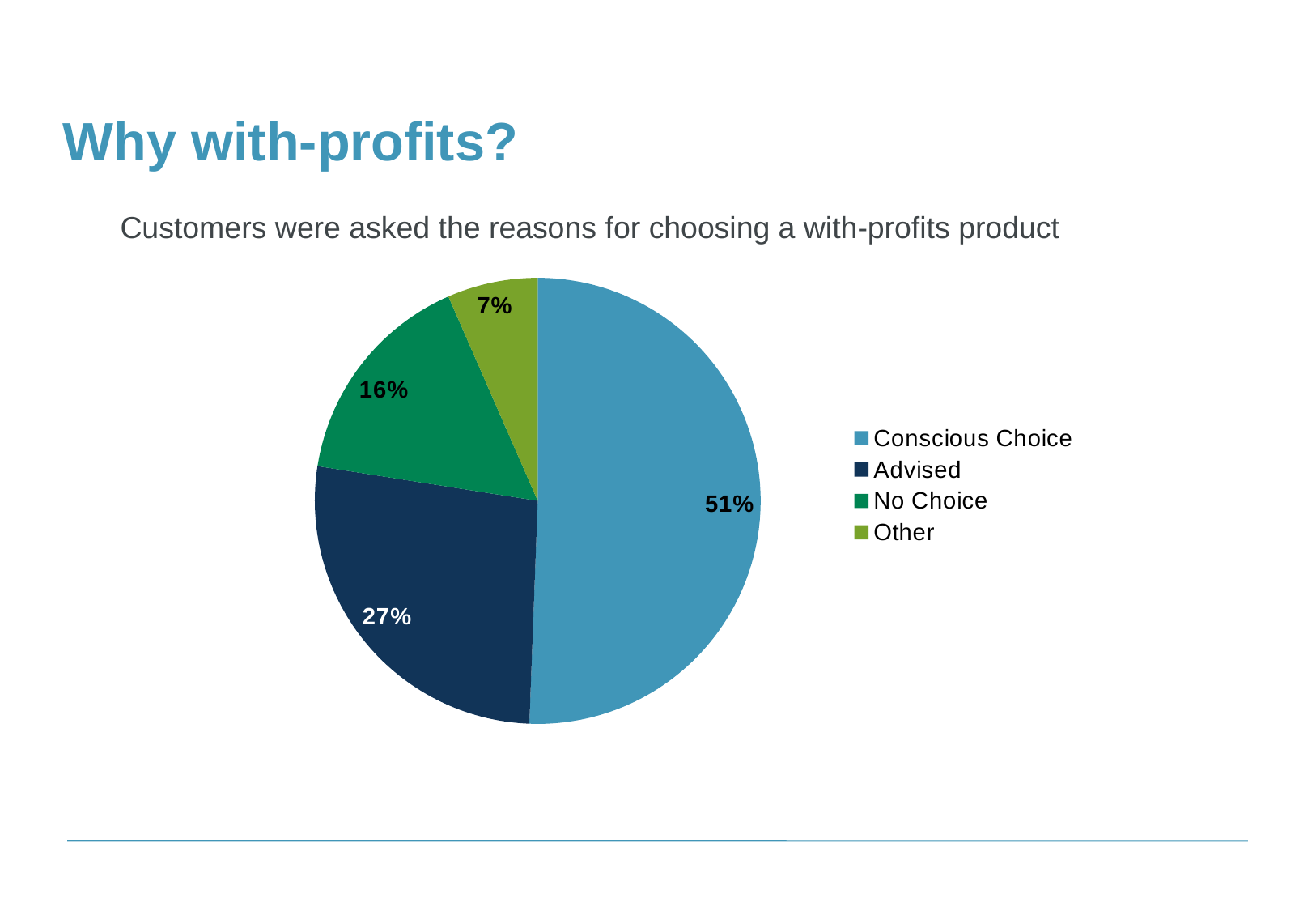
Which is larger, the share for No Choice or the share for Other? No Choice Which reason has the largest share of the pie? Conscious Choice Which reason has the smallest share of the pie? Other What percentage is shown for No Choice? 16% What percentage is shown for Other? 7% What share of the pie is labelled Advised? 27% What is the combined percentage of Advised and No Choice? 43% What percentage of customers chose a with-profits product as a Conscious Choice? 51% How many categories does the pie chart have? 4 What kind of chart is shown on the slide? pie chart Which category is shown in the light green colour in the legend? Other What is the difference in percentage points between Conscious Choice and Advised? 24